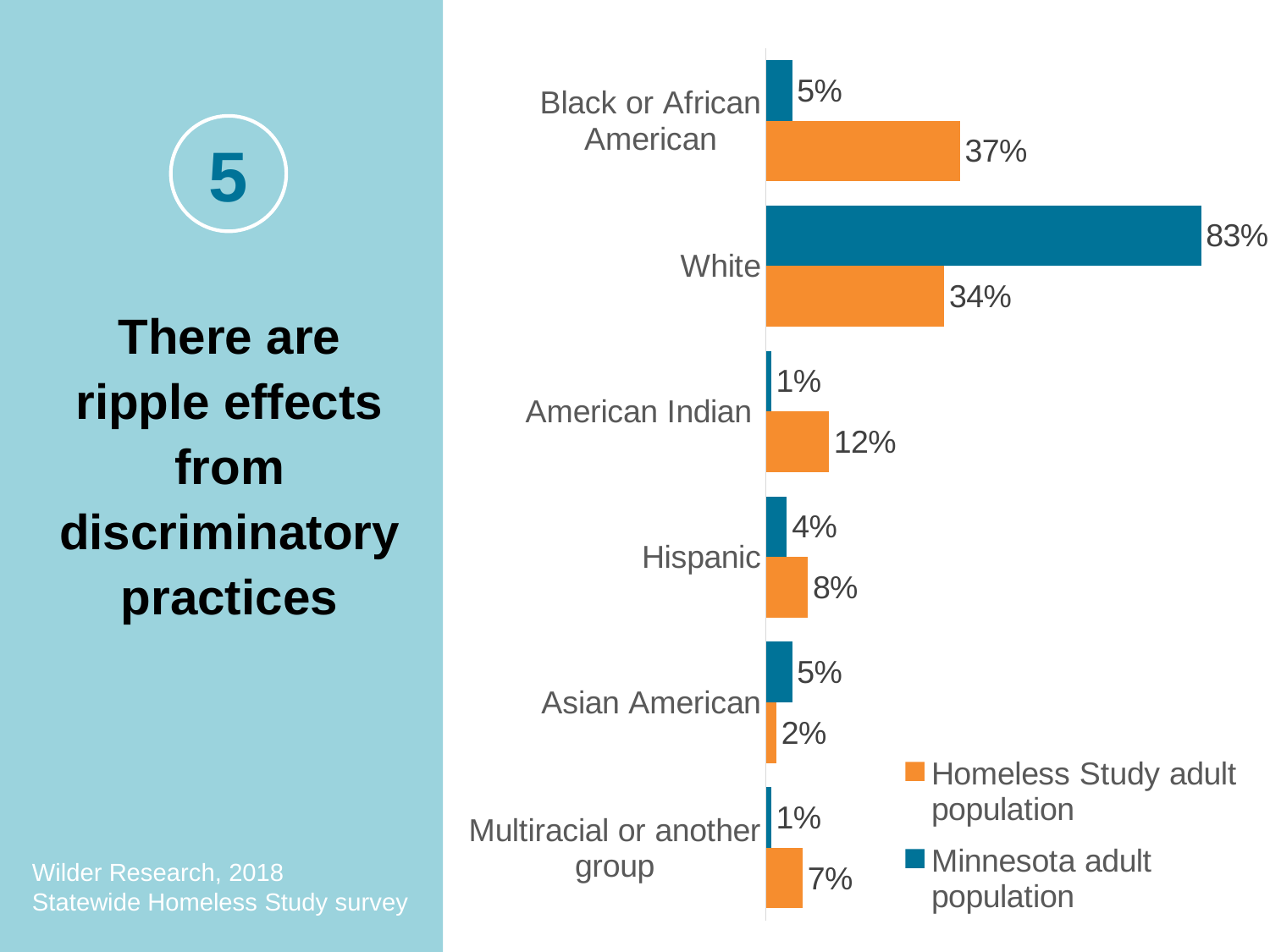
Which category has the lowest Homeless Study adult population value? Asian American What is the Homeless Study adult population value for Black or African American? 37% Which colour represents the Homeless Study adult population series? Orange What is the difference between the Minnesota adult population and Homeless Study adult population values for White? 49 percentage points How many series does the legend list? 2 What is the Minnesota adult population value for Hispanic? 4% What is the Homeless Study adult population value for American Indian? 12% What is the Minnesota adult population value for White? 83% What kind of chart is shown on the slide? Bar chart How many categories are shown on the chart? 6 Which category has the highest Homeless Study adult population value? Black or African American For Asian American, which is larger: the Minnesota adult population value or the Homeless Study adult population value? Minnesota adult population